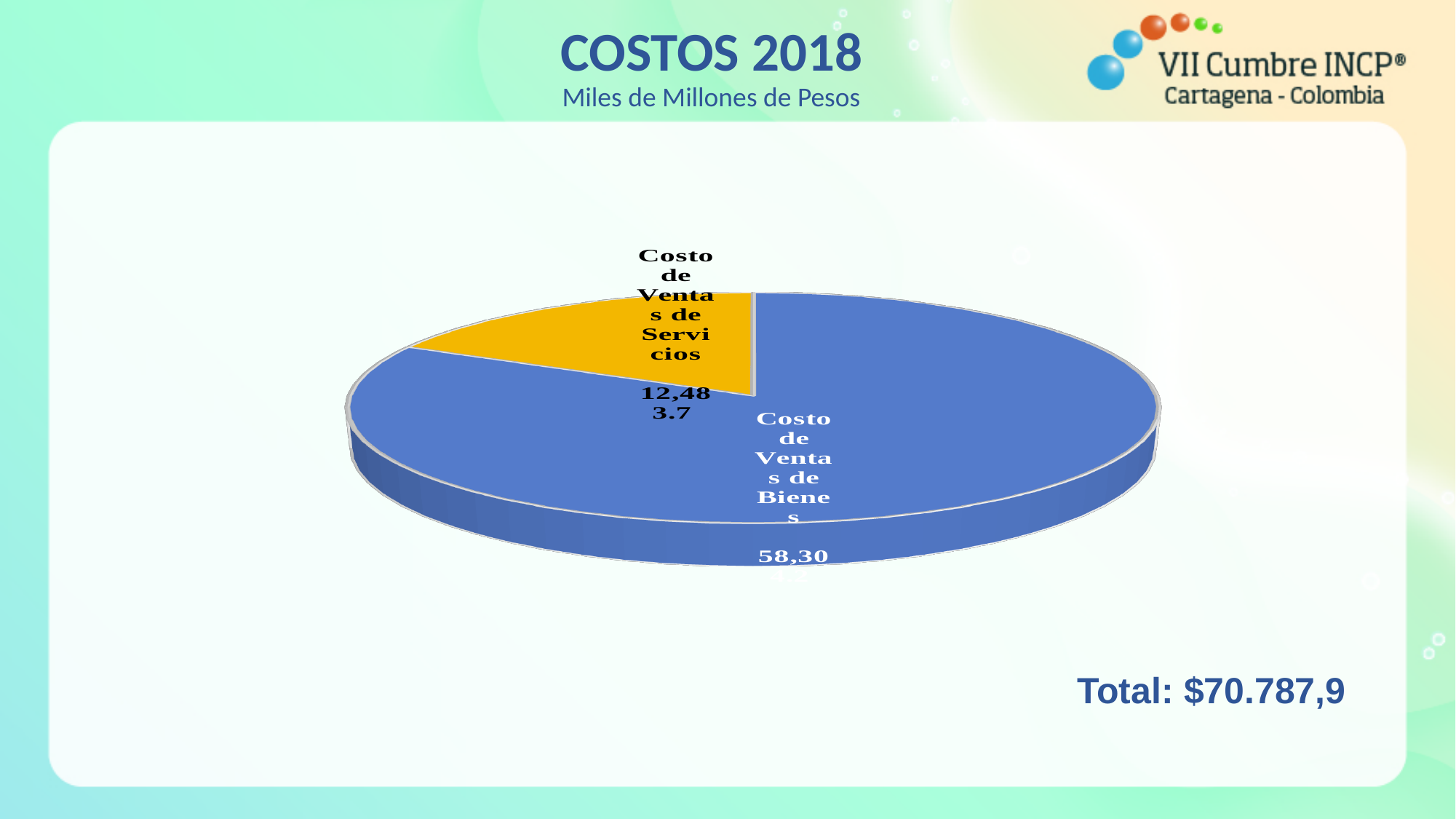
What kind of chart is shown on the slide? pie chart In what units are the values on the slide expressed, according to the subtitle? Miles de Millones de Pesos What is the value shown for Costo de Ventas de Servicios? 12,483.7 Which category has the largest slice of the pie? Costo de Ventas de Bienes Which is larger, Costo de Ventas de Bienes or Costo de Ventas de Servicios? Costo de Ventas de Bienes How many slices does the pie chart have? 2 What total is printed on the slide for the costs? $70.787,9 What is the title of the chart on the slide? COSTOS 2018 Which category has the smallest slice of the pie? Costo de Ventas de Servicios